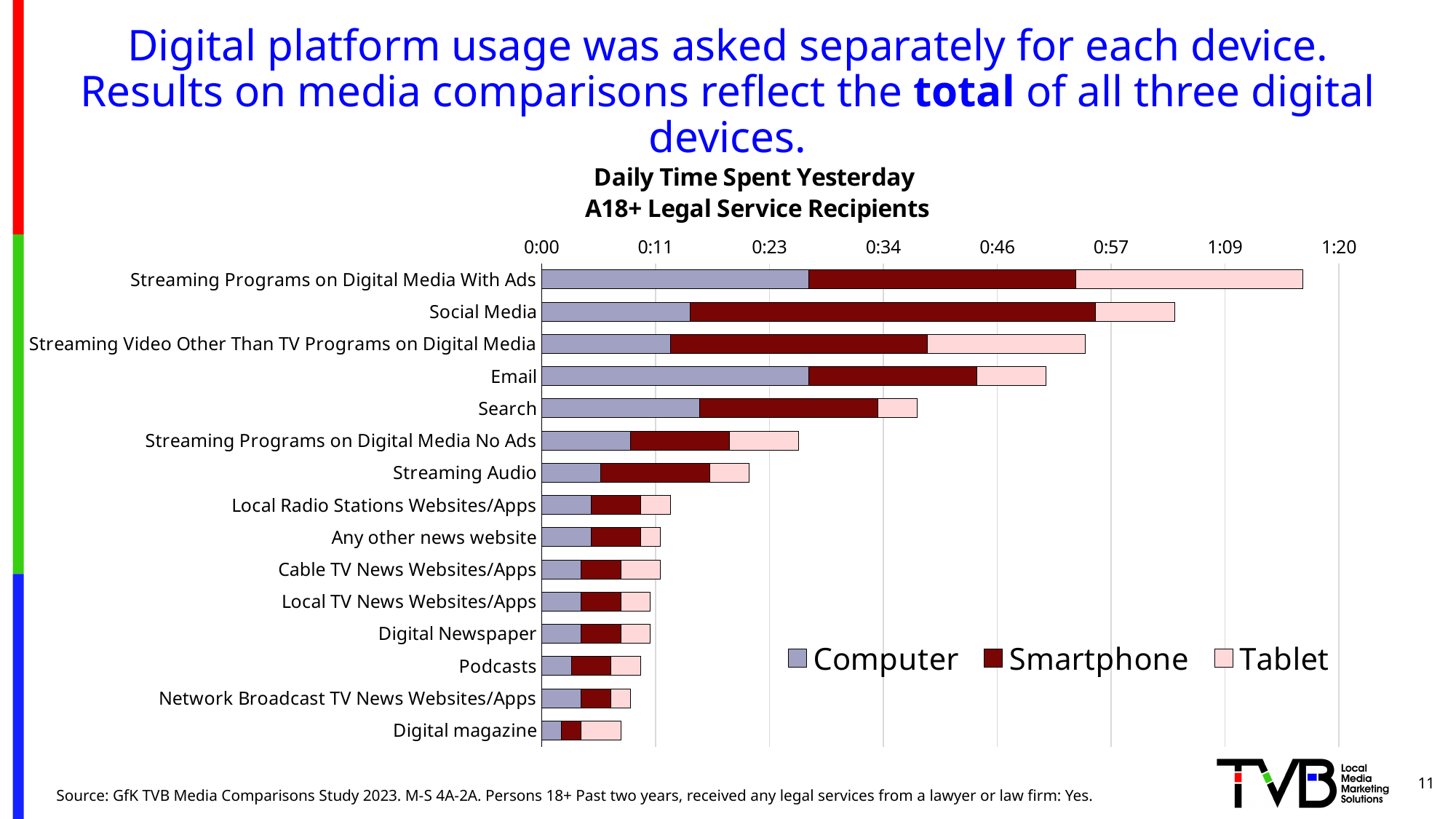
Is the total bar for Email greater or less than 0:57? less Is the total bar for Social Media greater or less than 0:57? greater Is the total bar for Streaming Programs on Digital Media With Ads greater or less than 1:09? greater How many series does the legend list? 3 What kind of chart is shown on the slide? Stacked bar chart How many categories (platforms) are plotted on the chart? 15 Do the total bar lengths increase or decrease going from the top category to the bottom category? decrease Which platform has the longest total bar? Streaming Programs on Digital Media With Ads Which series is shown in dark red in the legend? Smartphone Which has the larger total bar, Social Media or Email? Social Media